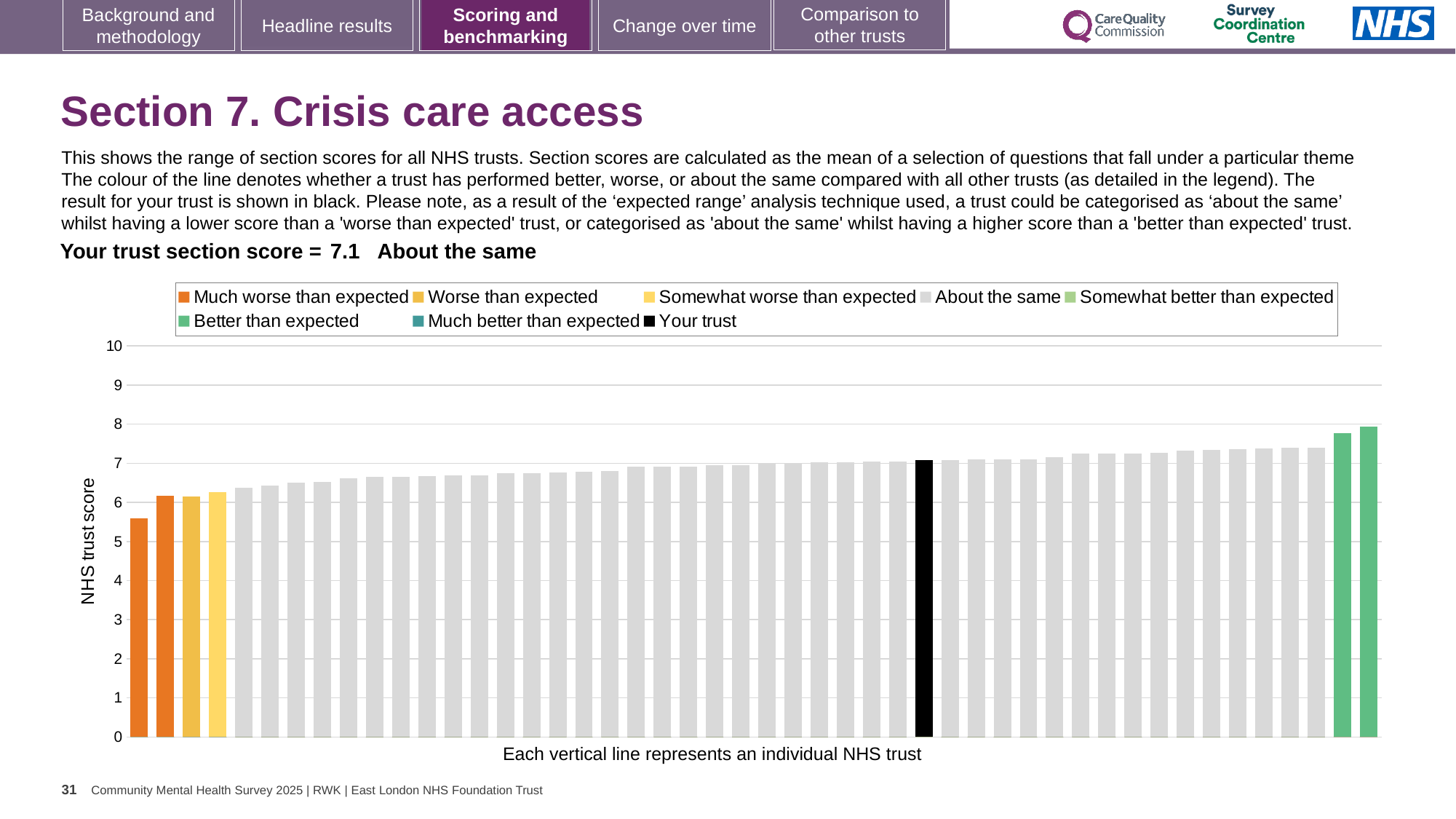
What is the section score for your trust shown above the chart? 7.1 How many entries does the chart legend list? 8 Is the value of the lowest (leftmost) bar greater or less than 6? less Which category is your trust placed in for this section? About the same How many bars are coloured orange (much worse than expected)? 2 What kind of chart is shown on the slide? Bar chart What is the label on the vertical axis of the chart? NHS trust score Do the bar values rise or fall from left to right along the x axis? Rise Which is higher: the black bar for your trust or the leftmost orange bar? The black bar for your trust Is the value of the highest (rightmost) bar greater or less than 7? greater How many bars are coloured green (better than expected)? 2